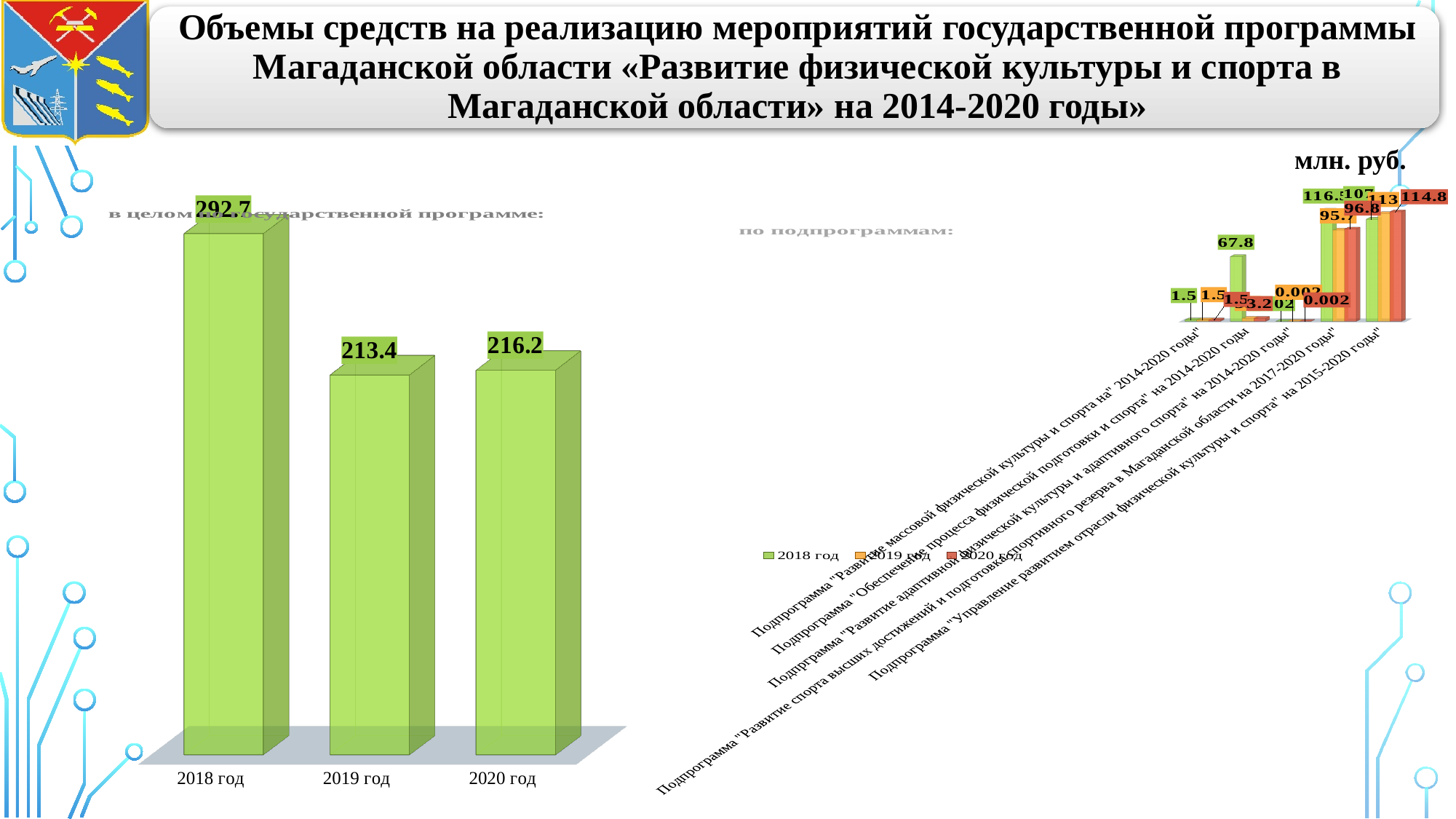
On the left chart (в целом по государственной программе), which year has the lowest value? 2019 год On the left chart (в целом по государственной программе), which year has the highest value? 2018 год On the left chart (в целом по государственной программе), what is the difference between the 2018 год and 2019 год values? 79.3 What kind of chart is the left chart (в целом по государственной программе)? Bar chart On the left chart (в целом по государственной программе), how many bars are shown? 3 On the right chart (по подпрограммам), what is the 2020 год value for the subprogram «Управление развитием отрасли физической культуры и спорта» на 2015-2020 годы? 114.8 On the right chart (по подпрограммам), how many series does the legend list? 3 On the left chart (в целом по государственной программе), what is the value for 2018 год? 292.7 On the left chart (в целом по государственной программе), what is the value for 2020 год? 216.2 On the left chart (в целом по государственной программе), which is larger, the value for 2019 год or 2020 год? 2020 год On the left chart (в целом по государственной программе), what is the value for 2019 год? 213.4 On the right chart (по подпрограммам), how many subprogram categories are shown on the x axis? 5